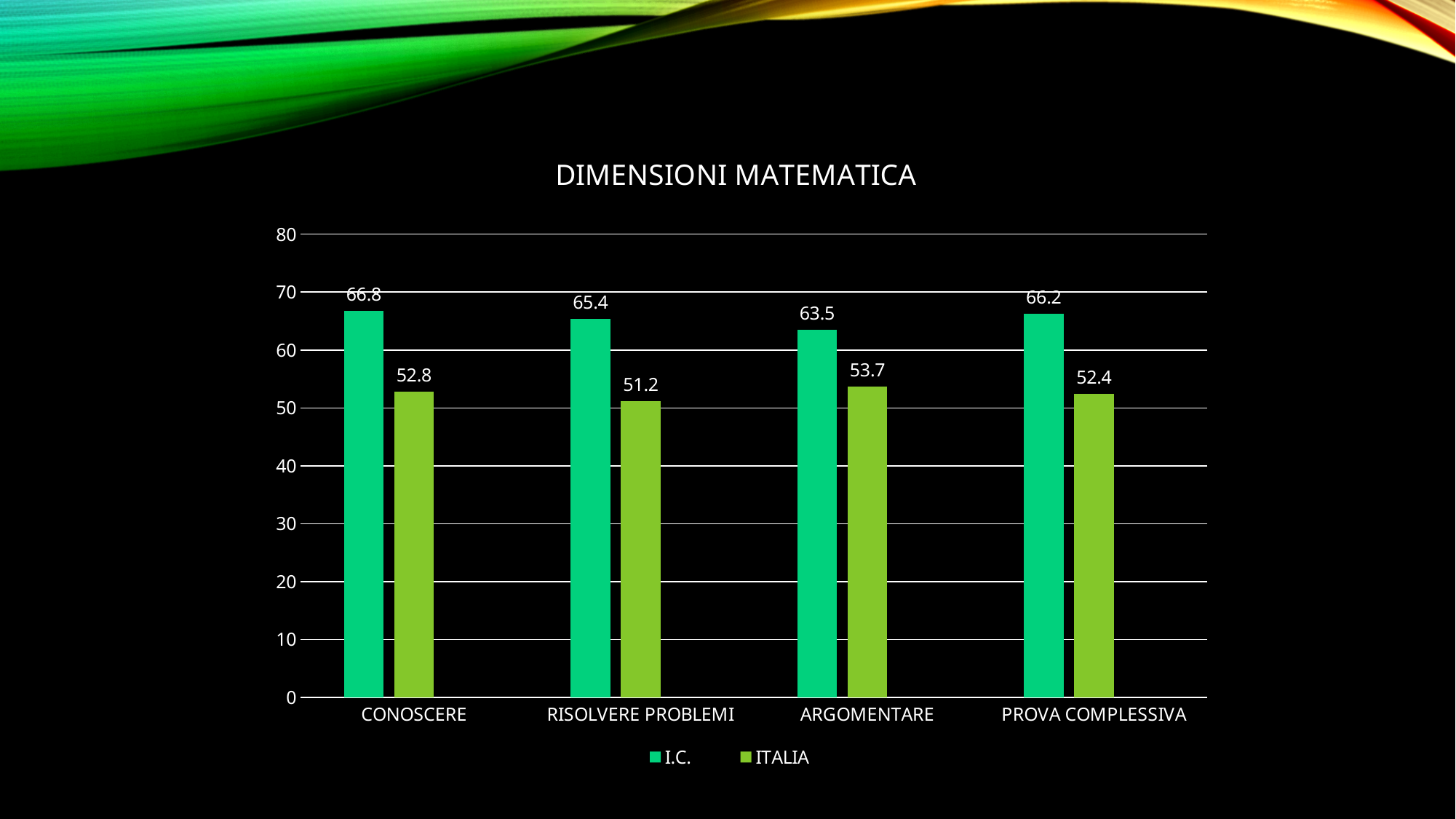
What kind of chart is shown on the slide? Bar chart Which category has the lowest ITALIA value? RISOLVERE PROBLEMI Which is larger for ARGOMENTARE, the I.C. value or the ITALIA value? I.C. Which category has the highest I.C. value? CONOSCERE What is the I.C. value for PROVA COMPLESSIVA? 66.2 What is the I.C. value for CONOSCERE? 66.8 What is the ITALIA value for RISOLVERE PROBLEMI? 51.2 What is the title of the chart? DIMENSIONI MATEMATICA How many categories are shown on the x axis? 4 How many series does the legend list? 2 What is the ITALIA value for ARGOMENTARE? 53.7 What is the difference between the I.C. and ITALIA values for CONOSCERE? 14